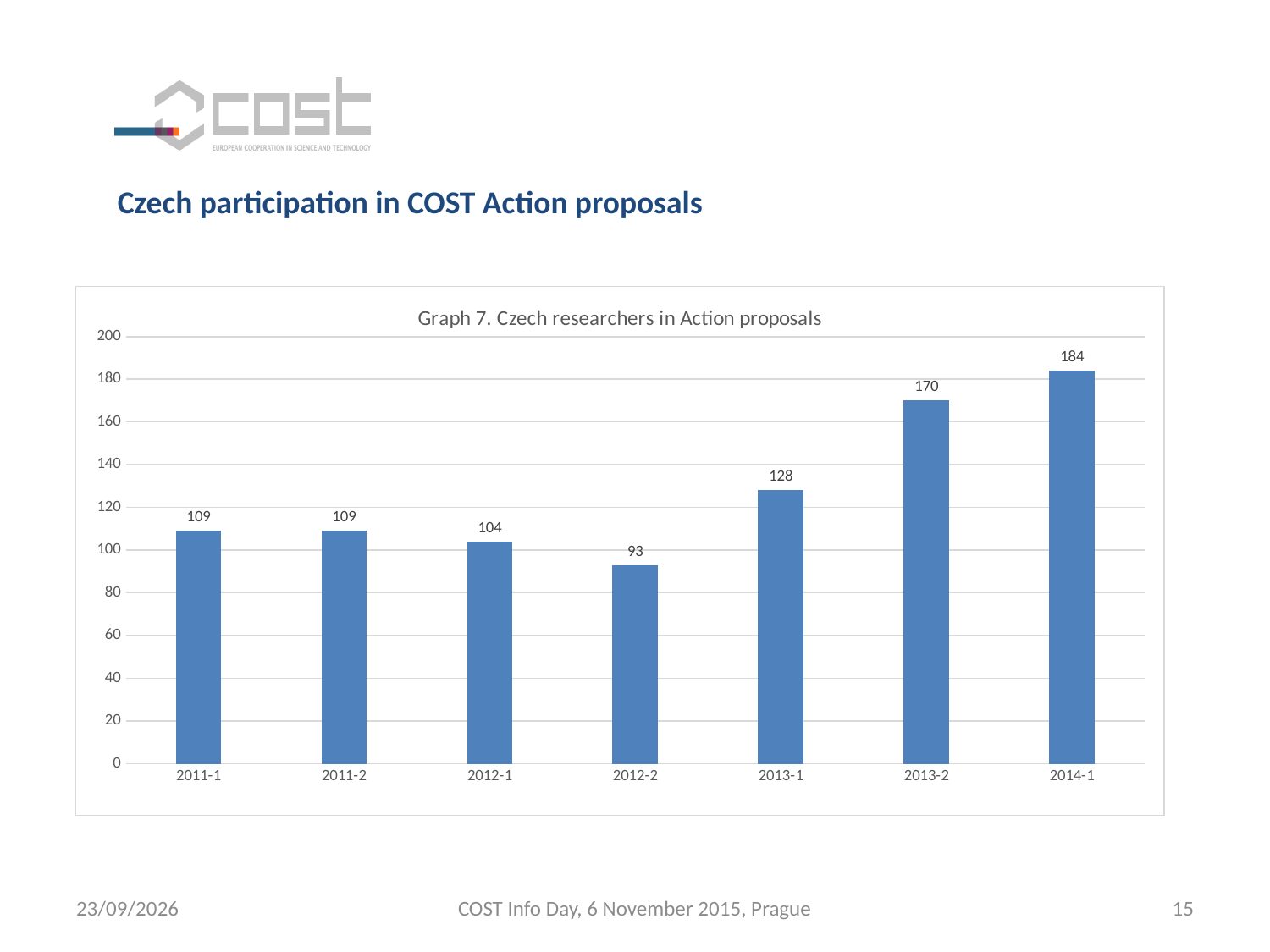
Which category has the highest value? 2014-1 What kind of chart is shown? bar chart Is the value for 2013-2 greater or less than 160? greater How many categories are shown on the x axis? 7 What is the value for 2013-2? 170 What is the value for 2012-2? 93 Which category has the lowest value? 2012-2 What is the difference between the values for 2013-1 and 2012-2? 35 Which is larger, the value for 2012-1 or the value for 2013-1? 2013-1 What is the difference between the values for 2014-1 and 2013-2? 14 What is the value for 2011-1? 109 What is the title of the chart? Graph 7. Czech researchers in Action proposals